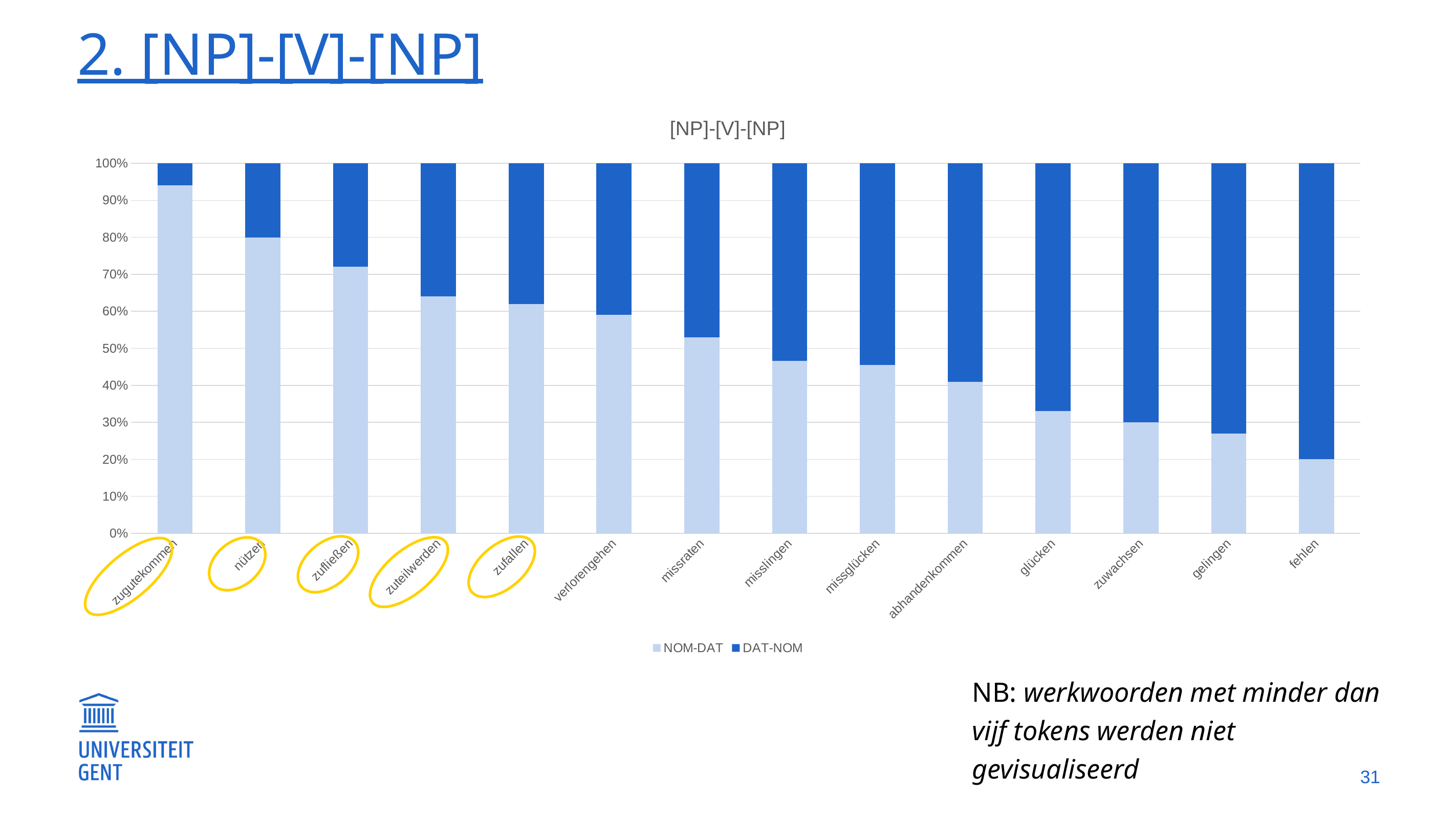
Which verb has the highest NOM-DAT share? zugutekommen How many verbs (categories) are shown on the x axis of the chart? 14 Which verb has the largest DAT-NOM share? fehlen Is the NOM-DAT share for verlorengehen greater or less than 50%? greater Which verb has a larger NOM-DAT share, zufließen or glücken? zufließen Does the NOM-DAT share rise or fall moving from left to right along the x axis? fall What is the title of the chart? [NP]-[V]-[NP] What kind of chart is shown on the slide? Stacked bar chart Is the NOM-DAT share for misslingen greater or less than 50%? less Is the NOM-DAT share for zugutekommen greater or less than 90%? greater How many series does the chart legend list? 2 Which verb has the lowest NOM-DAT share? fehlen